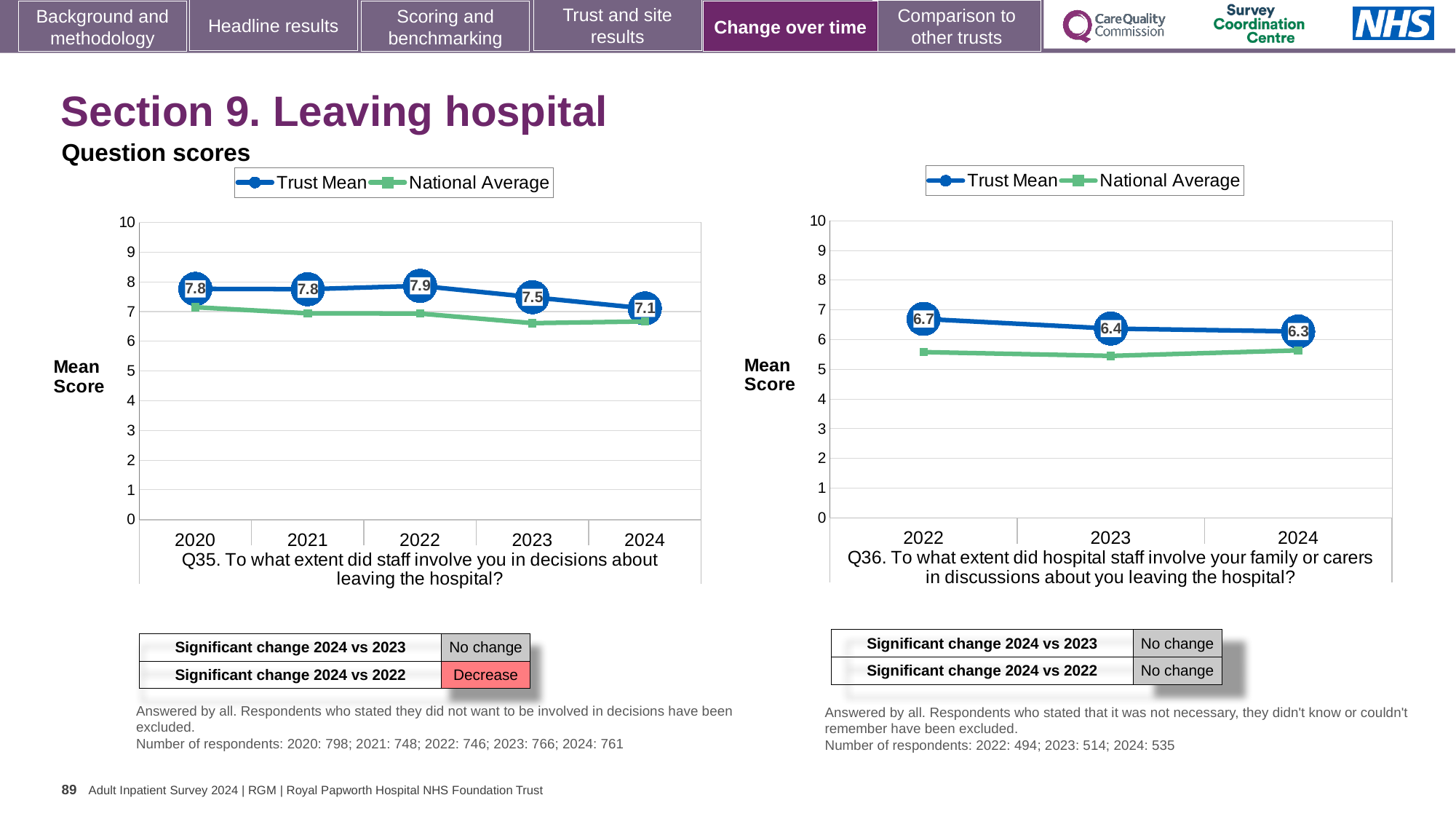
In the Q35 chart (left), how many years are plotted on the x axis? 5 In the Q35 chart (left), which year has the lowest Trust Mean? 2024 What type of chart is the Q36 chart (right)? line chart In the Q36 chart (right), what is the Trust Mean for 2022? 6.7 In the Q36 chart (right), does the Trust Mean rise or fall from 2022 to 2024? fall In the Q35 chart (left), what is the Trust Mean for 2024? 7.1 In the Q35 chart (left), what is the difference between the Trust Mean in 2022 and in 2024? 0.8 In the Q35 chart (left), which year has the highest Trust Mean? 2022 In the Q35 chart (left), what is the Trust Mean for 2022? 7.9 In the Q36 chart (right), what is the difference between the Trust Mean in 2022 and in 2024? 0.4 In the Q35 chart (left), is the National Average for 2024 greater or less than 7? less In the Q36 chart (right), how many series does the legend list? 2